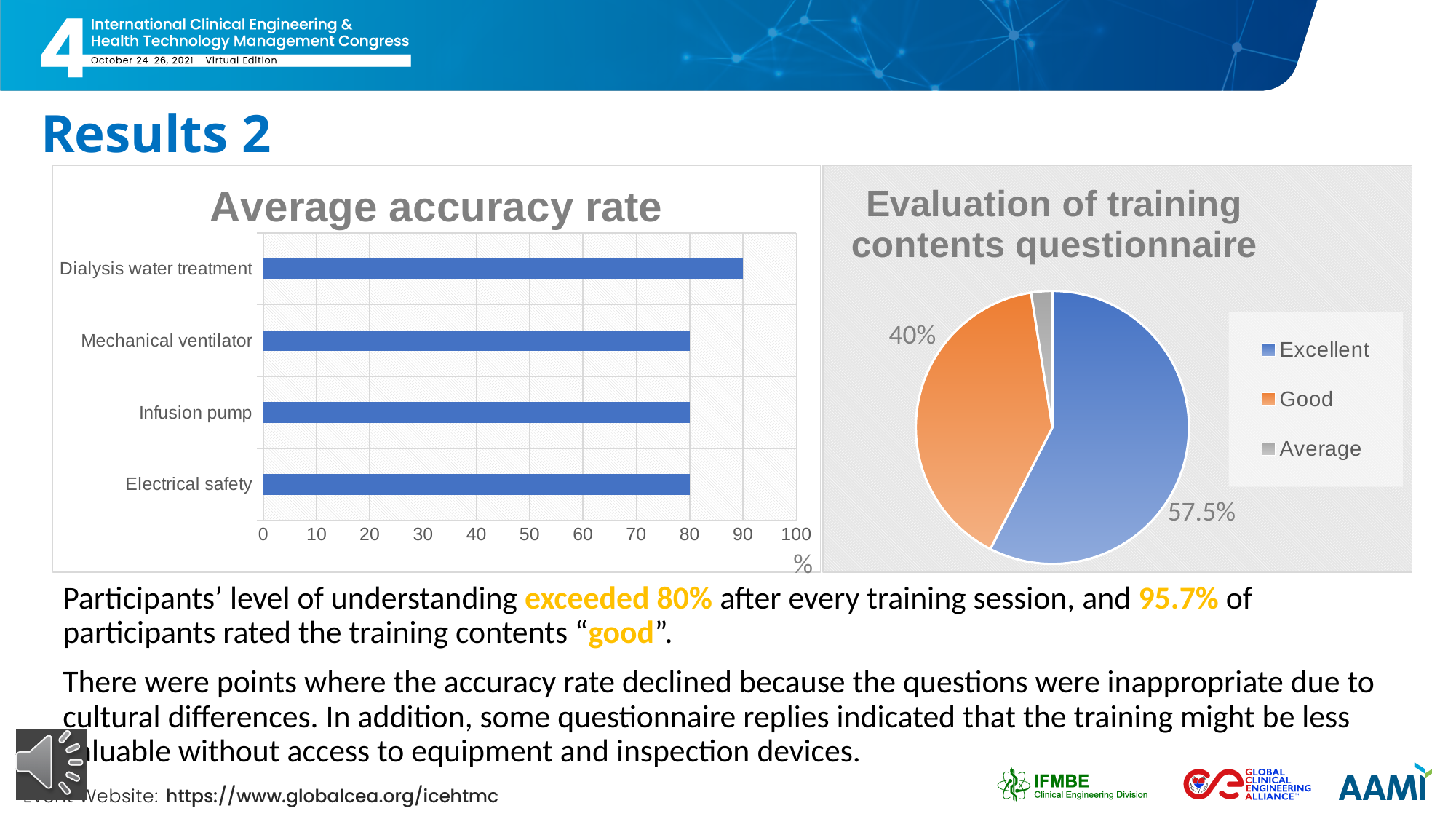
In the "Evaluation of training contents questionnaire" pie chart, what share is labelled for Excellent? 57.5% In the "Evaluation of training contents questionnaire" pie chart, which slice is the largest? Excellent In the "Evaluation of training contents questionnaire" pie chart, what is the difference between the Excellent and Good shares? 17.5% In the "Average accuracy rate" chart, which category has the highest value? Dialysis water treatment In the "Average accuracy rate" chart, which is larger: Dialysis water treatment or Electrical safety? Dialysis water treatment In the "Average accuracy rate" chart, is the value for Mechanical ventilator greater or less than 50? greater What kind of chart is the "Evaluation of training contents questionnaire" chart? pie chart In the "Average accuracy rate" chart, what is the value for Dialysis water treatment? 90 How many categories are shown in the "Average accuracy rate" chart? 4 How many entries does the legend of the "Evaluation of training contents questionnaire" chart list? 3 What kind of chart is the "Average accuracy rate" chart? bar chart In the "Evaluation of training contents questionnaire" pie chart, what share is labelled for Good? 40%